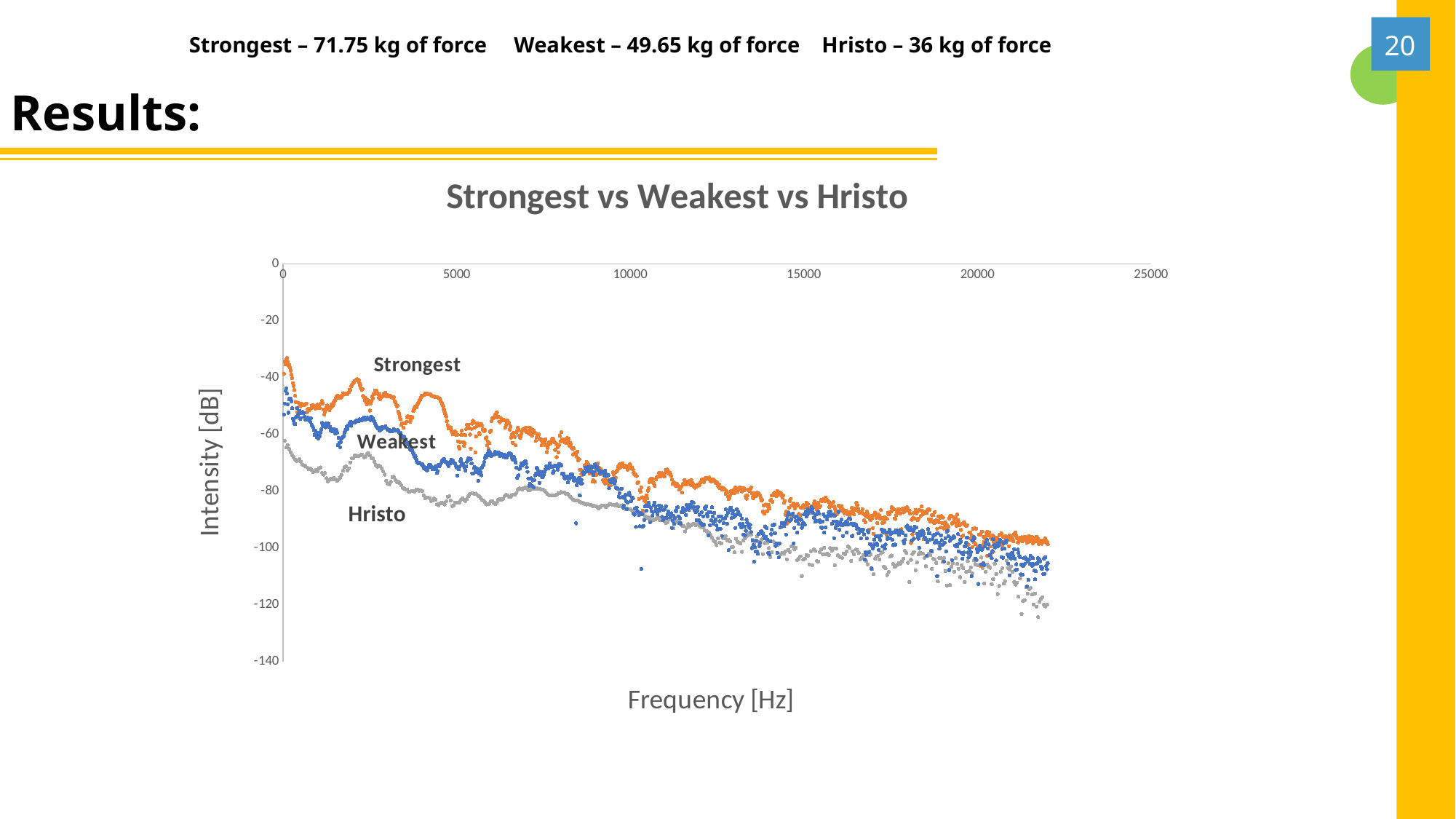
Do the intensity values for the Strongest series rise or fall as frequency increases along the x axis? fall Which series has the lowest intensity values across the frequency range? Hristo Is the intensity of the Strongest series at around 20000 Hz greater or less than -80 dB? less Is the intensity of the Hristo series at around 5000 Hz greater or less than -60 dB? less Is the intensity of the Strongest series near 0 Hz greater or less than -60 dB? greater At around 5000 Hz, which series has the larger intensity, Strongest or Hristo? Strongest How many data series are plotted on the chart? 3 What is the label of the chart's y axis? Intensity [dB] What is the highest frequency value shown on the x axis? 25000 Which series has the highest intensity values across the frequency range? Strongest What is the title of the chart? Strongest vs Weakest vs Hristo What kind of chart is shown on the slide? scatter chart